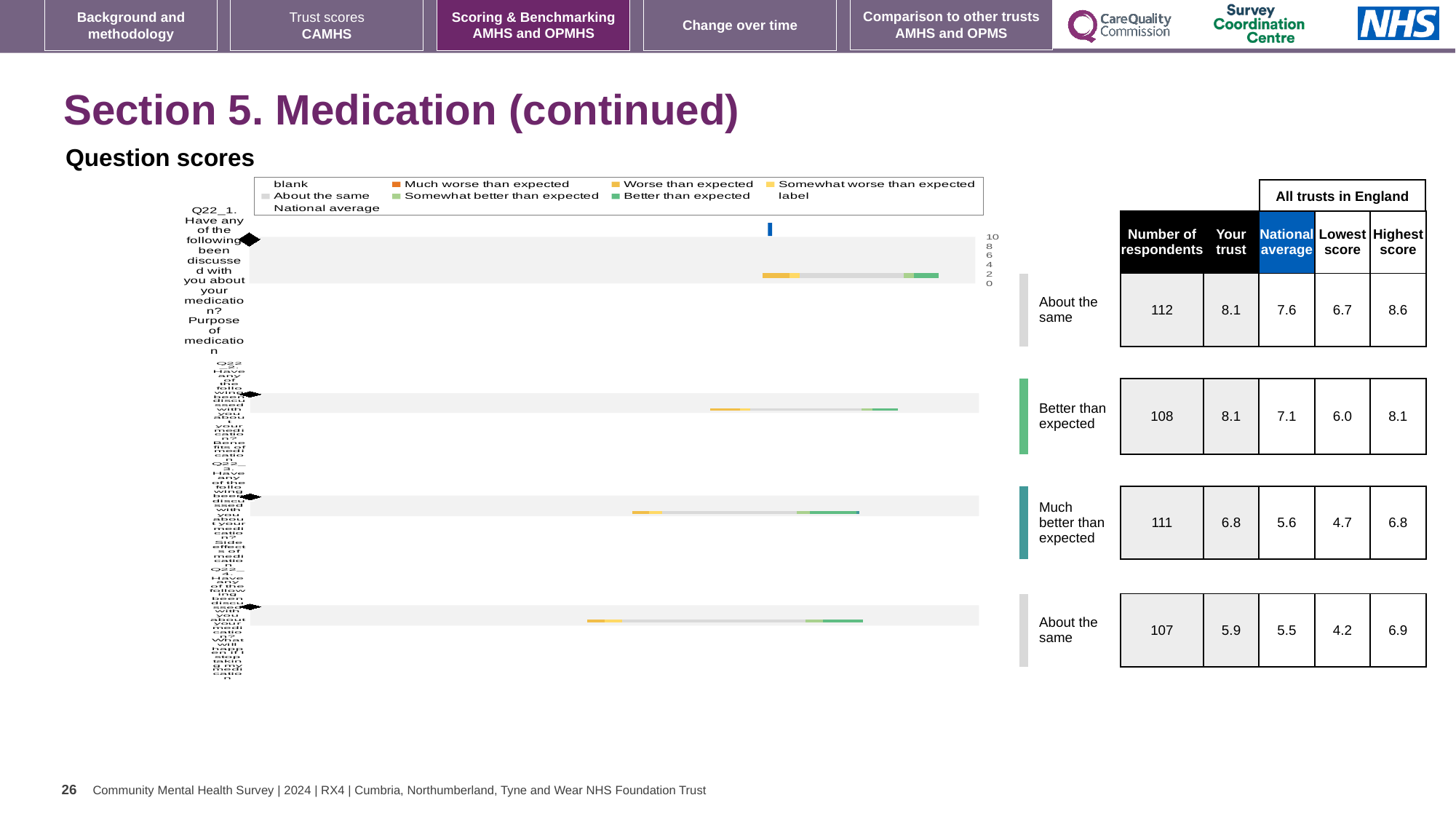
In the second row (Better than expected), is the 'Your trust' score or the national average larger? Your trust (8.1) Which row of the table has the lowest 'Your trust' score? the fourth row (5.9) In the table next to the chart, what is the highest score for the fourth row? 6.9 In the table next to the chart, what is the 'Your trust' score for the first row (Q22_1, Purpose of medication)? 8.1 What benchmark label is shown beside the third bar of the chart? Much better than expected In the table next to the chart, what is the national average for the first row (Q22_1, Purpose of medication)? 7.6 How many question bars are plotted in the chart? 4 What kind of chart is shown on the slide? bar chart Which row of the table has the highest number of respondents? the first row (112) What is the difference between the 'Your trust' score and the national average in the third row (Much better than expected)? 1.2 In the table next to the chart, how many respondents are listed for the third row (Much better than expected)? 111 In the table next to the chart, what is the lowest score for the second row (Better than expected)? 6.0